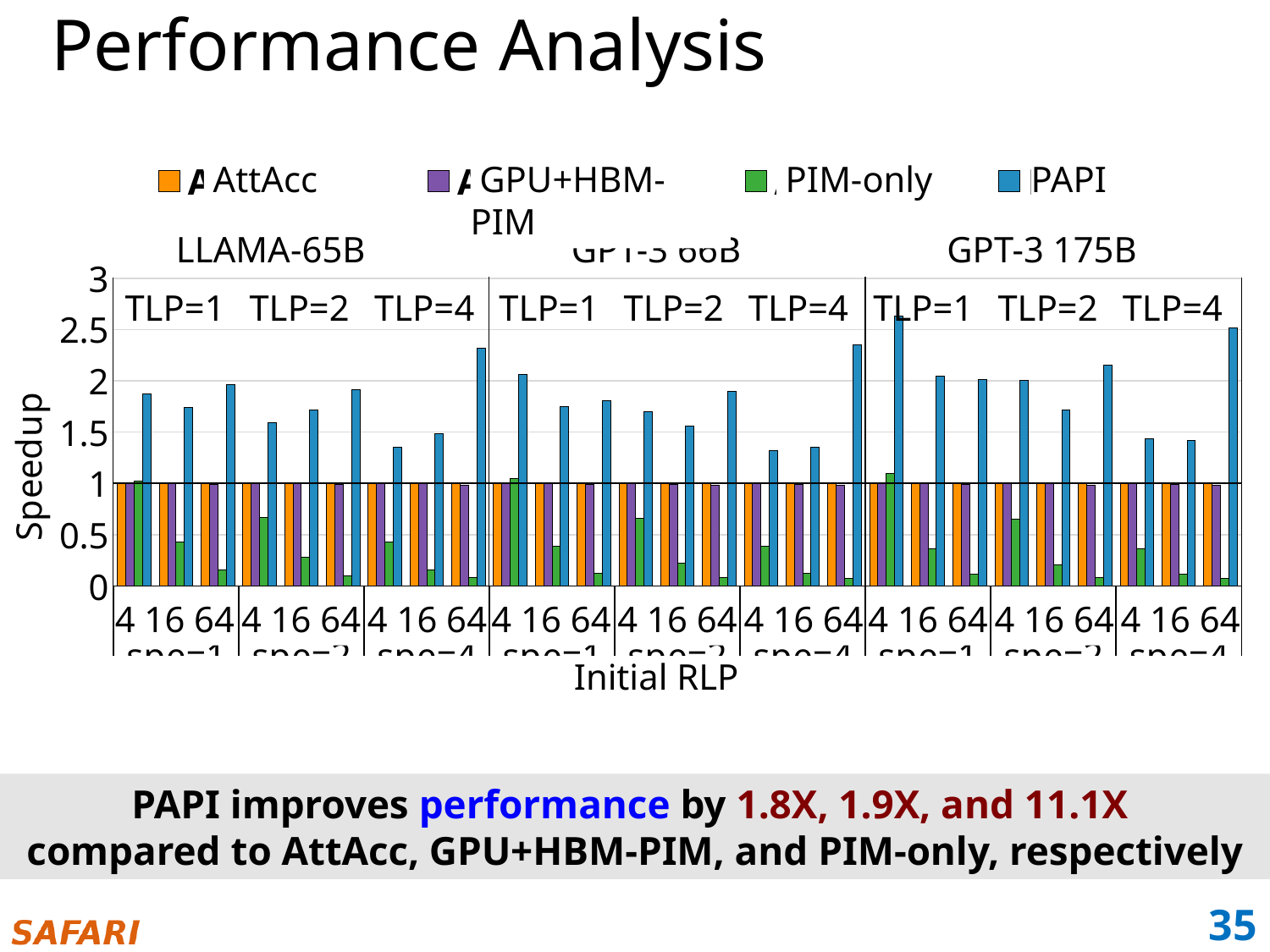
What kind of chart is shown on the slide? bar chart For LLAMA-65B, TLP=1, does the PIM-only speedup rise or fall as Initial RLP increases from 4 to 64? fall Is the PAPI speedup for GPT-3 175B, TLP=1, Initial RLP=4 greater or less than 2.5? greater What is the label of the y-axis? Speedup How many series does the legend list? 4 What is the label of the x-axis? Initial RLP How many model groups (LLAMA-65B, GPT-3 66B, GPT-3 175B) are shown along the x-axis? 3 Is the PAPI speedup for LLAMA-65B, TLP=4, Initial RLP=64 greater or less than 2? greater Is the PIM-only speedup for LLAMA-65B, TLP=1, Initial RLP=64 greater or less than 0.5? less For GPT-3 175B, TLP=4, Initial RLP=64, which is larger: the PAPI speedup or the PIM-only speedup? PAPI What is the speedup of AttAcc for LLAMA-65B, TLP=1, Initial RLP=4? 1